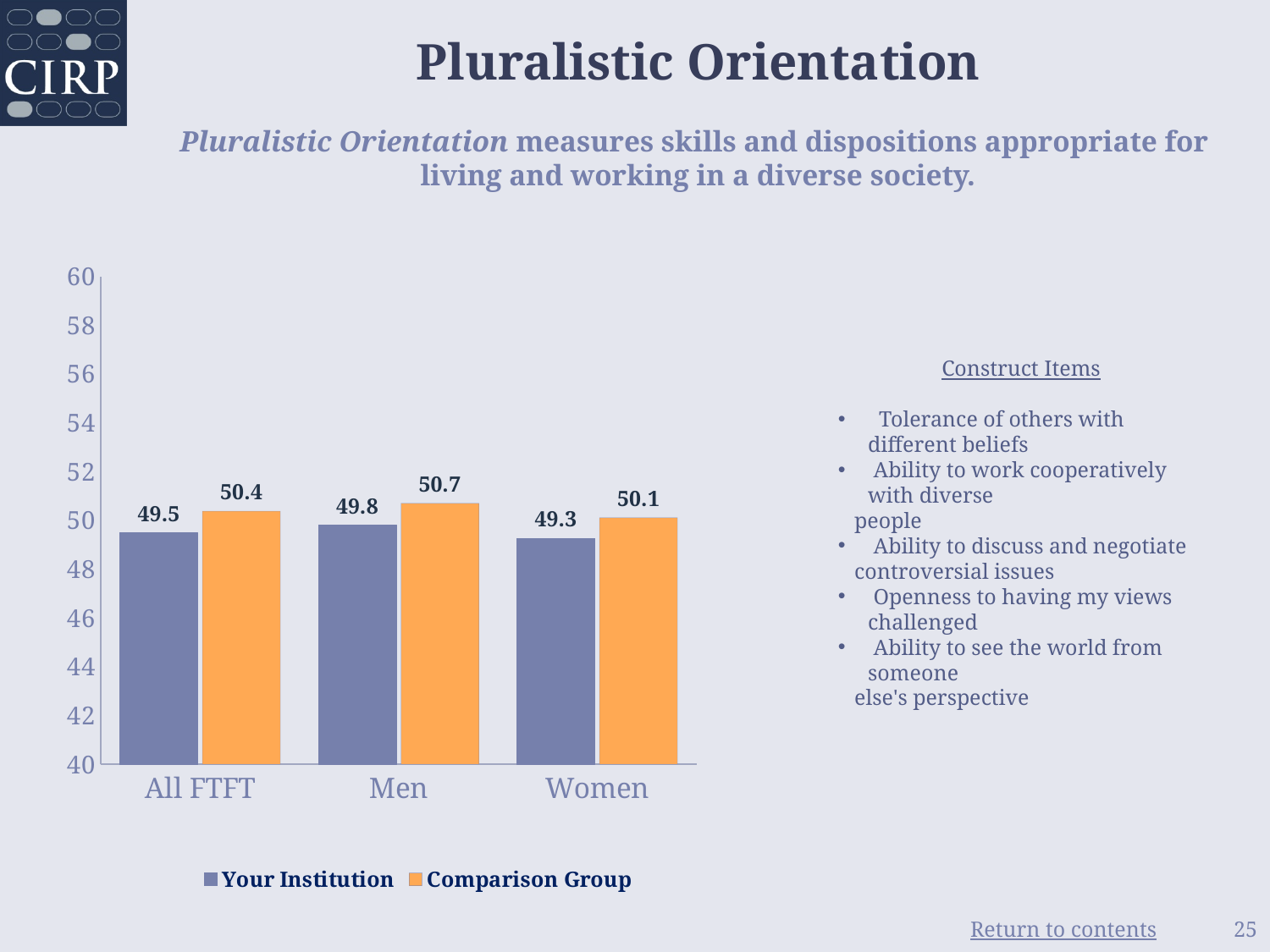
How many categories are shown on the x axis? 3 Which category has the highest value for the Comparison Group series? Men What is the difference between the Comparison Group and Your Institution values for Men? 0.9 What is the value for Comparison Group in the Men category? 50.7 For All FTFT, which is larger: Your Institution or Comparison Group? Comparison Group How many series does the legend list? 2 What is the value for Your Institution in the All FTFT category? 49.5 What colour are the Comparison Group bars? Orange What kind of chart is shown on the slide? Bar chart Which category has the lowest value for the Your Institution series? Women What is the value for Your Institution in the Women category? 49.3 What is the value for Comparison Group in the Women category? 50.1